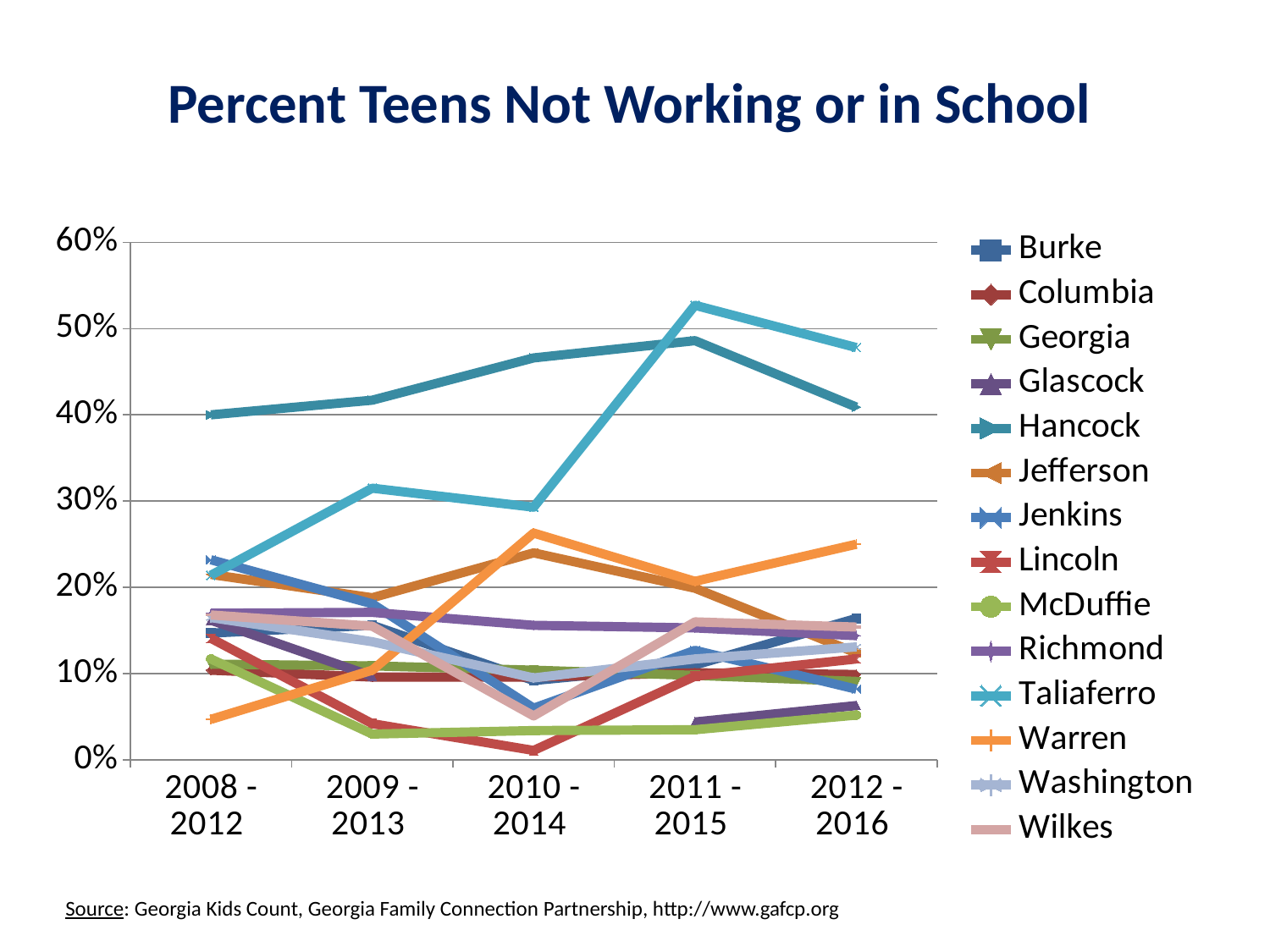
Is the value for Lincoln in 2010 - 2014 greater or less than 10%? less Which series has the lowest value in 2008 - 2012? Warren What is the title of the chart? Percent Teens Not Working or in School Does the value for Hancock rise or fall from 2008 - 2012 to 2011 - 2015? rise Which series has the highest value in 2008 - 2012? Hancock What kind of chart is shown on the slide? line chart In 2011 - 2015, which is larger, the value for Taliaferro or the value for Hancock? Taliaferro Which series has the highest value in 2012 - 2016? Taliaferro How many series does the legend list? 14 Is the value for Warren in 2012 - 2016 greater or less than 20%? greater Is the value for Taliaferro in 2011 - 2015 greater or less than 50%? greater How many time periods are shown on the x axis? 5